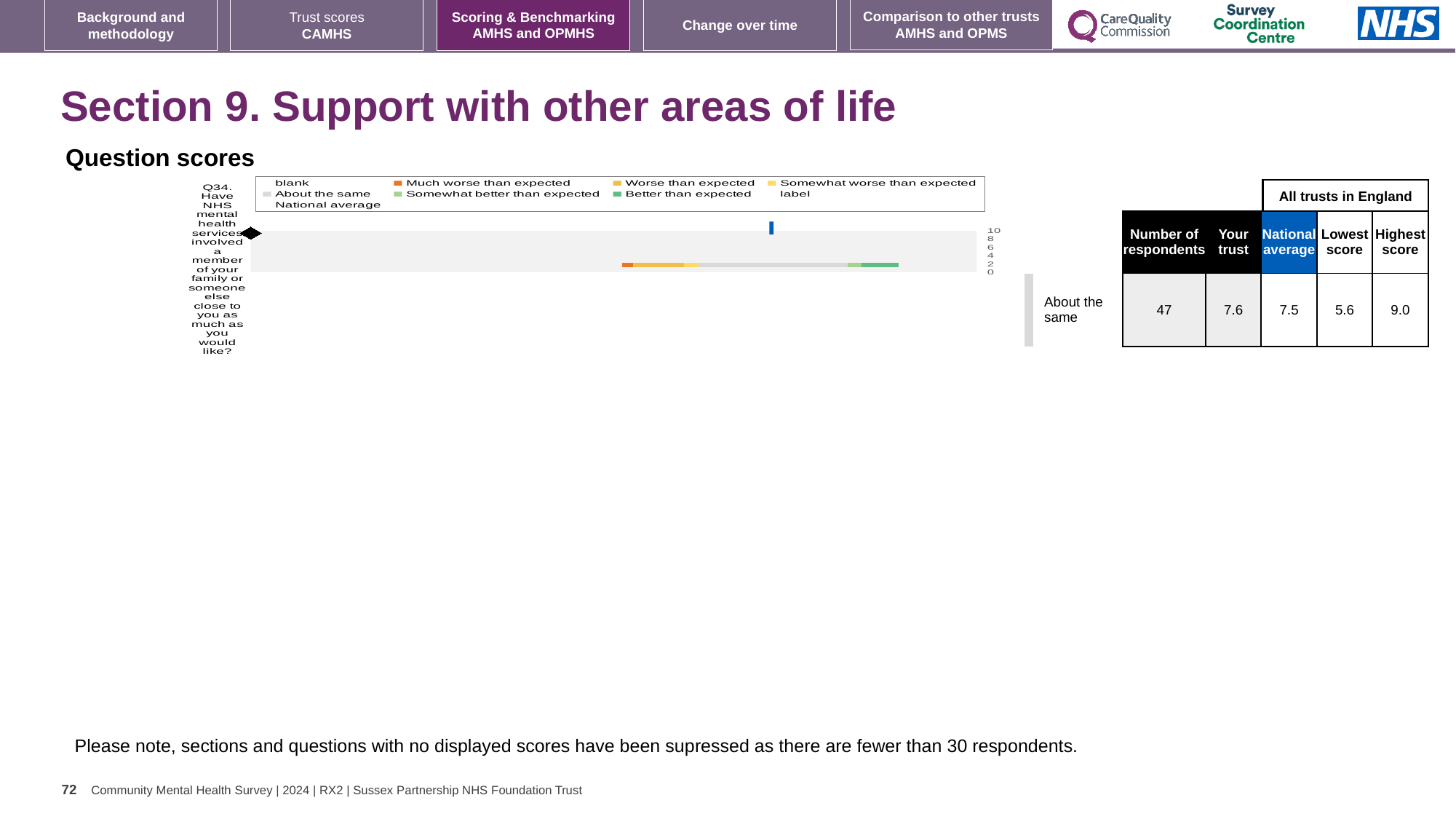
How many entries does the legend of the Question scores chart list? 9 Which benchmark category is the trust's score for Q34 placed in? About the same What kind of chart is used to show the Q34 question score? bar chart What is the national average score for Q34? 7.5 What is the difference between the highest score and the lowest score for Q34 across all trusts in England? 3.4 What is the highest score among all trusts in England for Q34? 9.0 What is the highest value shown on the score axis of the Question scores chart? 10 Which is larger for Q34, the 'Your trust' score or the national average? Your trust What is the 'Your trust' score for Q34? 7.6 How many questions are plotted in the Question scores chart? 1 What is the lowest score among all trusts in England for Q34? 5.6 How many respondents answered Q34? 47